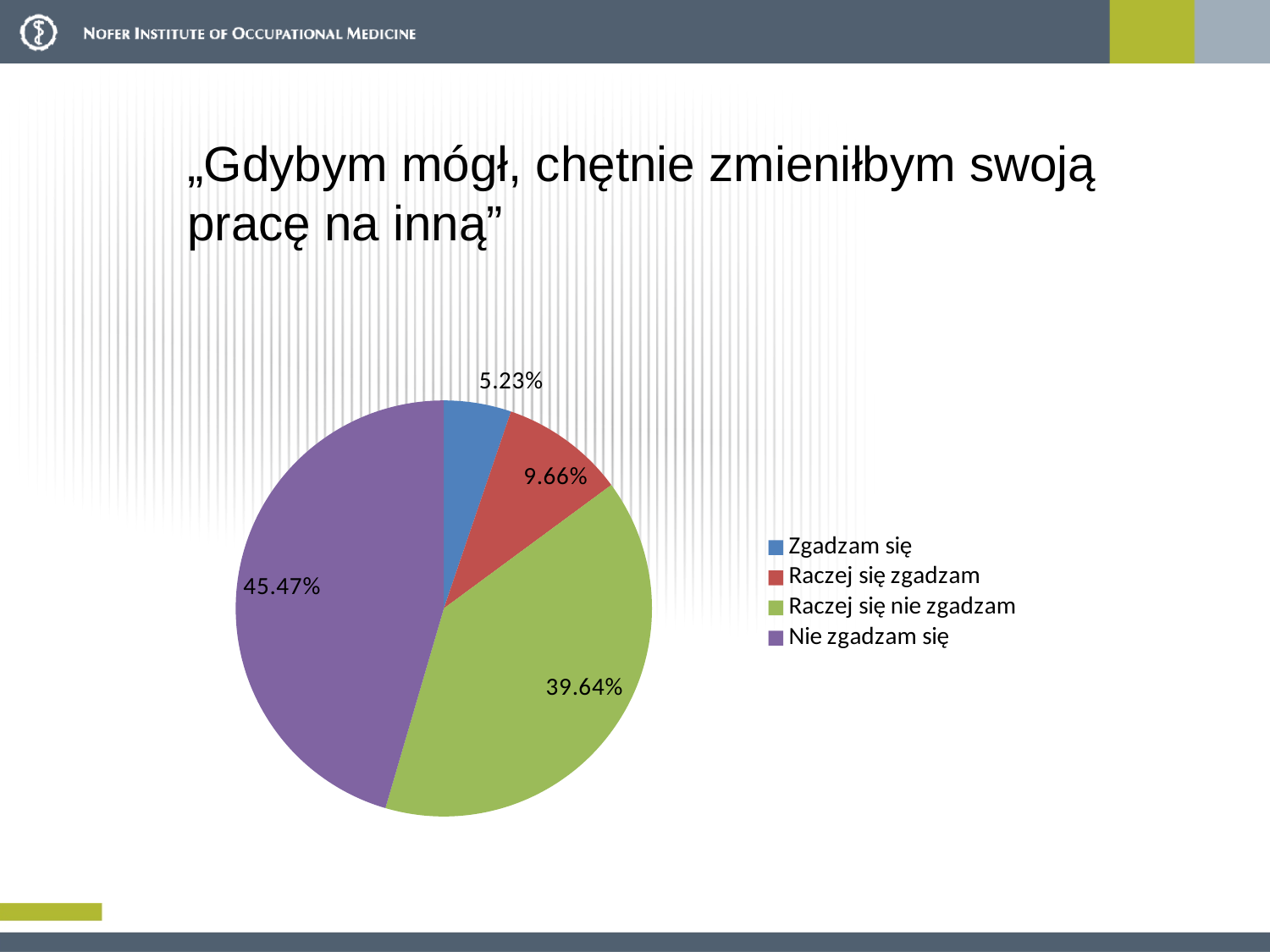
What is the combined share of "Zgadzam się" and "Raczej się zgadzam"? 14.89% Which is larger: the slice for "Raczej się zgadzam" or the slice for "Zgadzam się"? Raczej się zgadzam Which category has the largest slice of the pie? Nie zgadzam się What share of the pie is labelled "Raczej się nie zgadzam"? 39.64% What is the difference in percentage points between "Nie zgadzam się" and "Raczej się nie zgadzam"? 5.83 What kind of chart is shown on the slide? pie chart What colour is the slice for "Raczej się nie zgadzam"? green How many slices does the pie chart have? 4 What share of the pie is labelled "Zgadzam się"? 5.23% What share of the pie is labelled "Raczej się zgadzam"? 9.66% What share of the pie is labelled "Nie zgadzam się"? 45.47% Which category has the smallest slice of the pie? Zgadzam się